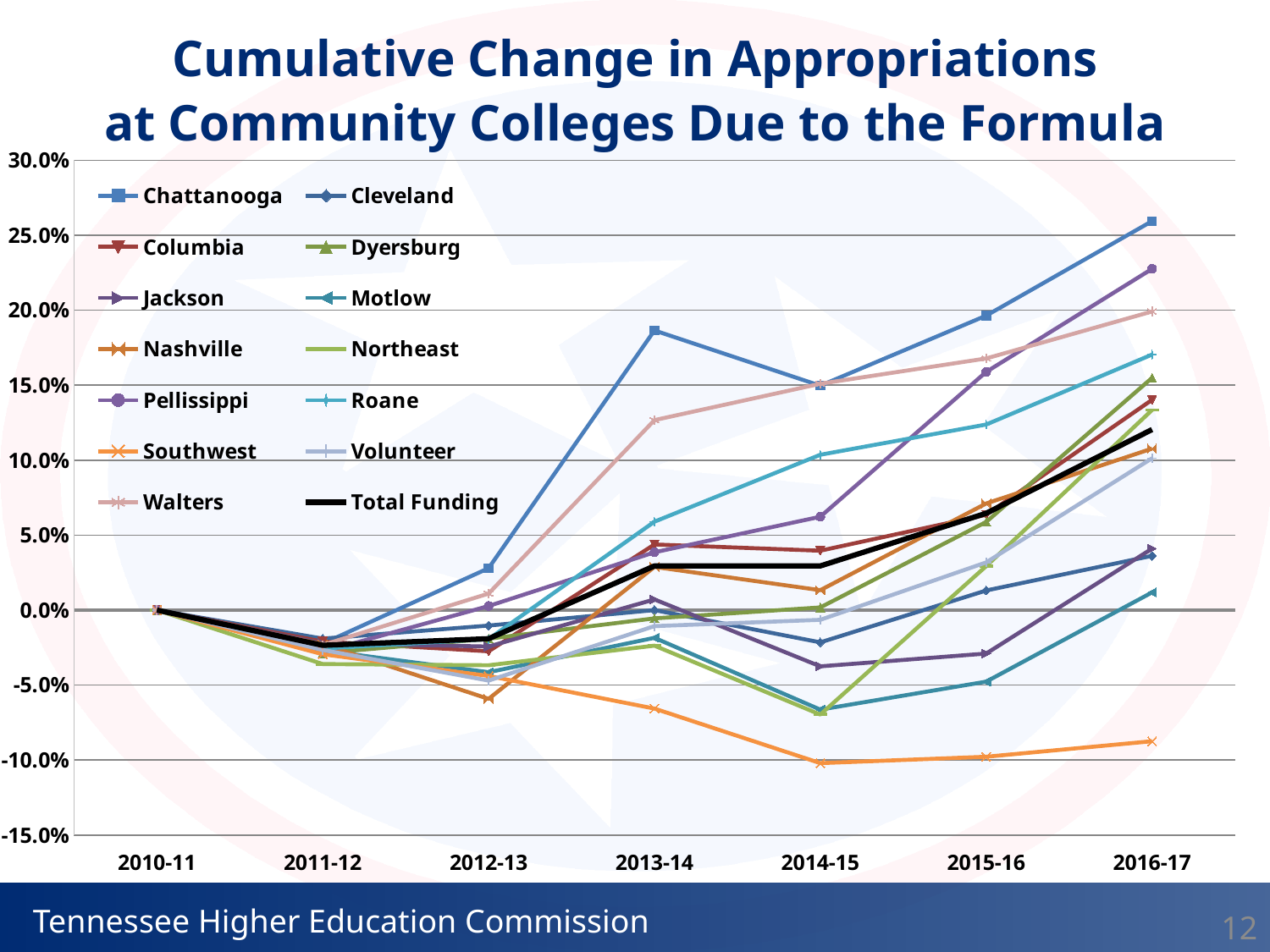
Which series has the highest value in 2016-17? Chattanooga Which series has the lowest value in 2014-15? Southwest How many series does the legend list? 14 Is the value for Southwest in 2016-17 greater or less than -5.0%? less What kind of chart is shown on the slide? line chart How many fiscal years are shown along the x axis? 7 What is the value for Total Funding in 2010-11? 0.0% Is the value for Pellissippi in 2016-17 greater or less than 20.0%? greater Does the Southwest line rise or fall from 2010-11 to 2014-15? fall Is the value for Chattanooga in 2013-14 greater or less than 15.0%? greater Which series has the lowest value in 2016-17? Southwest